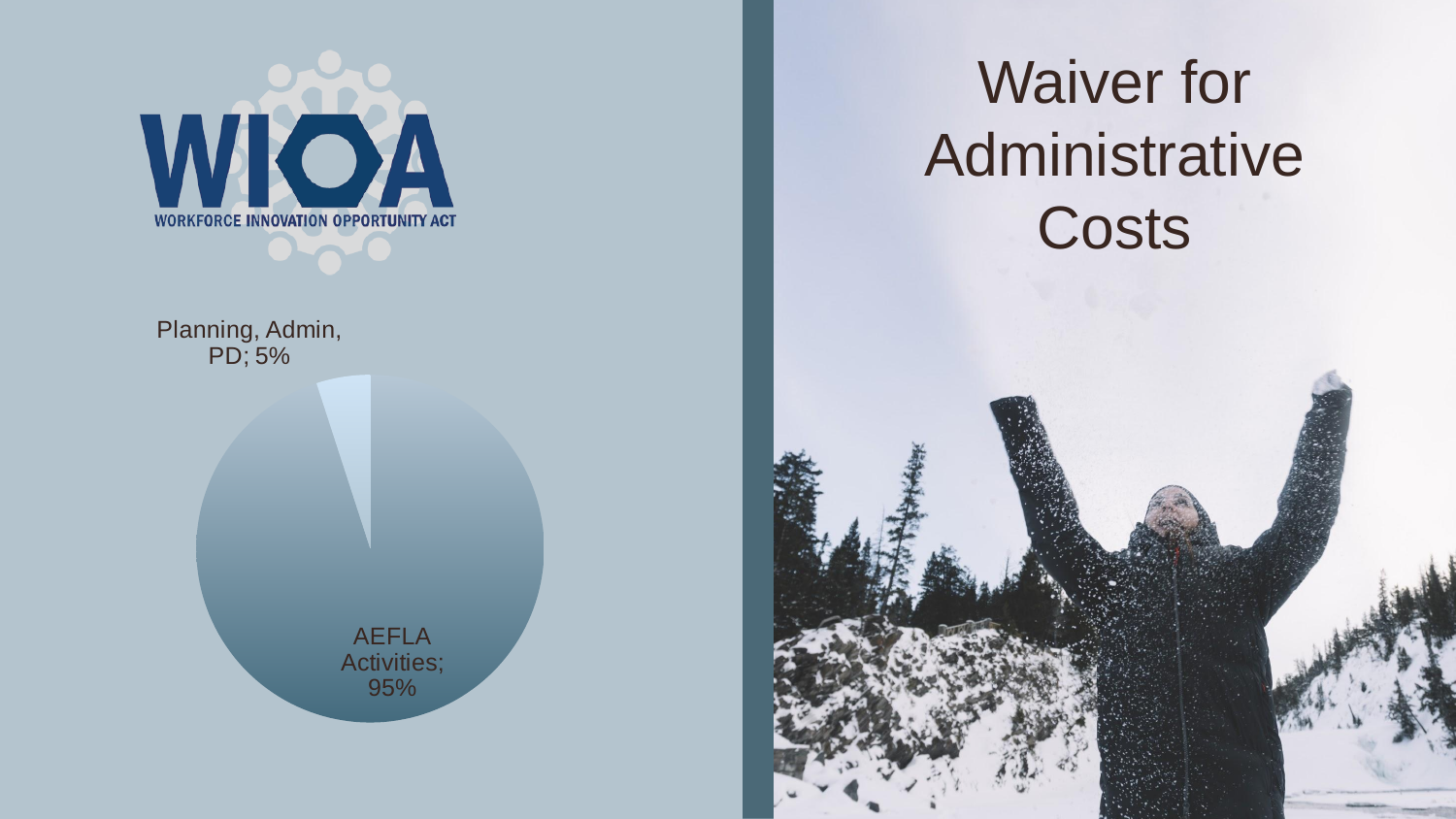
Which is larger, the AEFLA Activities slice or the Planning, Admin, PD slice? AEFLA Activities What share of the pie is labelled Planning, Admin, PD? 5% What is the difference in percentage points between the AEFLA Activities slice and the Planning, Admin, PD slice? 90 How many slices does the pie chart have? 2 What share of the pie is labelled AEFLA Activities? 95% Which slice of the pie chart is the smallest? Planning, Admin, PD What is the total of the two slices shown in the pie chart? 100% What kind of chart is shown on the slide? pie chart What is the title text shown on the right side of the slide? Waiver for Administrative Costs Which slice of the pie chart is the largest? AEFLA Activities